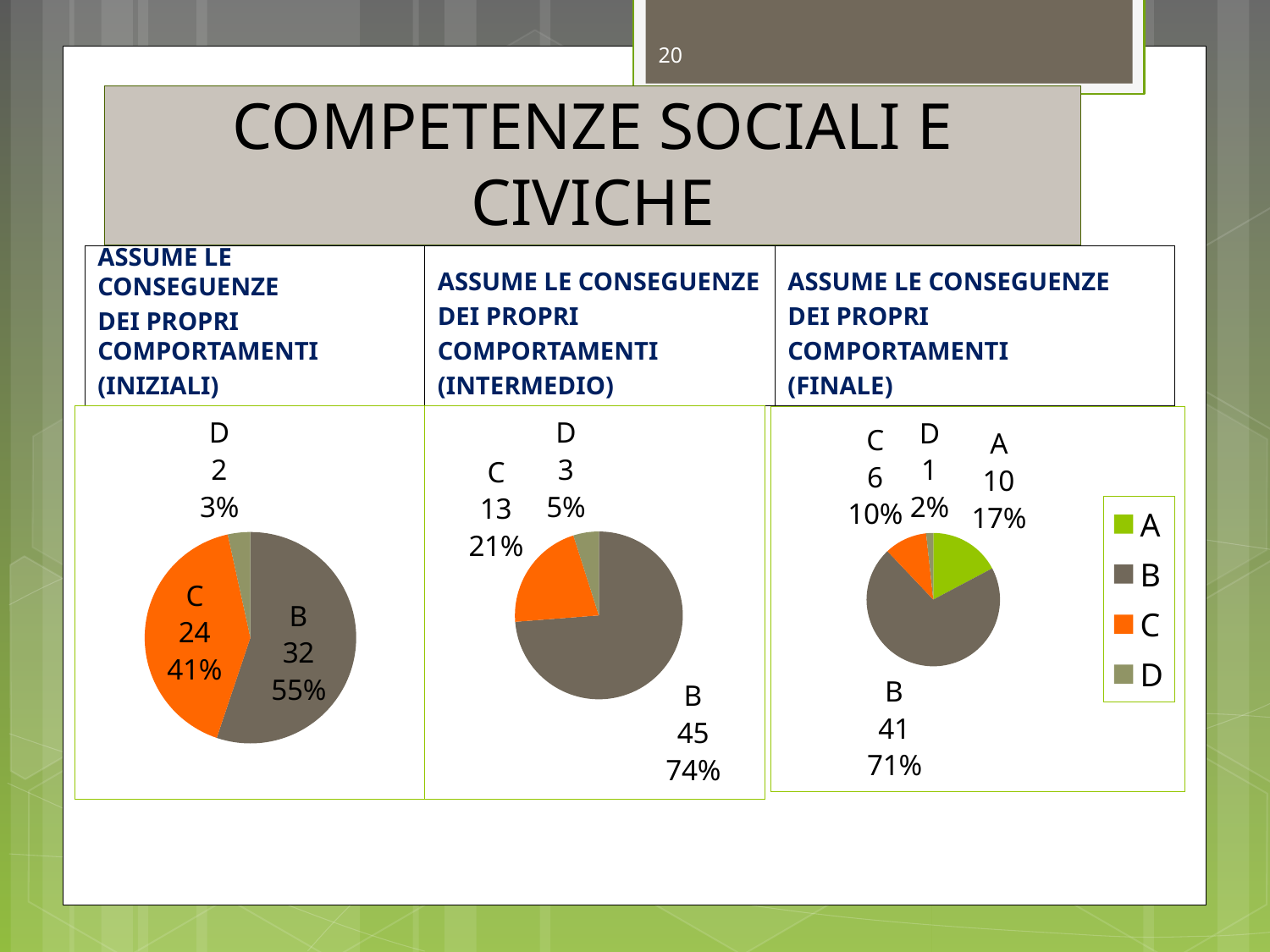
In the FINALE pie chart, which is larger, the value for C or the value for D? C In the FINALE pie chart, what is the value for category A? 10 In the INIZIALI pie chart, which category is the smallest? D In the FINALE pie chart, which category is the largest? B In the INIZIALI pie chart, what is the value for category B? 32 What kind of chart is used in the INIZIALI panel? Pie chart In the FINALE pie chart, how many categories are shown? 4 In the INTERMEDIO pie chart, what share of the pie does category B represent? 74% In the INTERMEDIO pie chart, what is the difference between the values for B and C? 32 In the INTERMEDIO pie chart, what is the value for category C? 13 How many entries does the legend next to the FINALE chart list? 4 In the INIZIALI pie chart, what share of the pie does category C represent? 41%